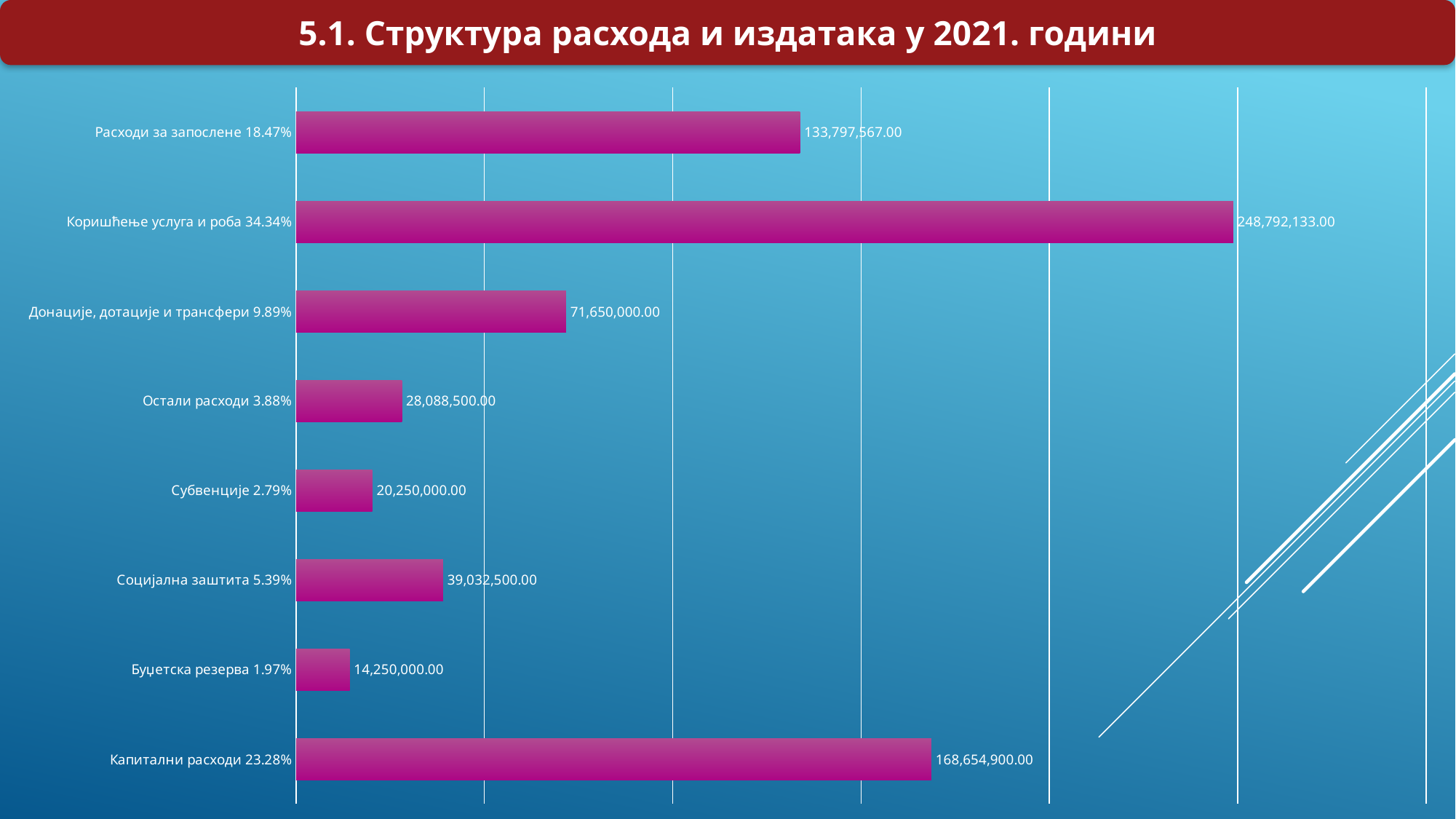
How many categories are shown in the chart? 8 Which is larger, the value for Донације, дотације и трансфери or the value for Социјална заштита? Донације, дотације и трансфери What is the difference between the values for Коришћење услуга и роба and Капитални расходи? 80,137,233.00 What is the difference between the values for Социјална заштита and Остали расходи? 10,944,000.00 What is the value for Капитални расходи? 168,654,900.00 Which category has the highest value? Коришћење услуга и роба What is the value for Коришћење услуга и роба? 248,792,133.00 What is the value for Расходи за запослене? 133,797,567.00 What kind of chart is shown on the slide? Bar chart What is the title of the slide? 5.1. Структура расхода и издатака у 2021. години Which category has the lowest value? Буџетска резерва What is the value for Буџетска резерва? 14,250,000.00